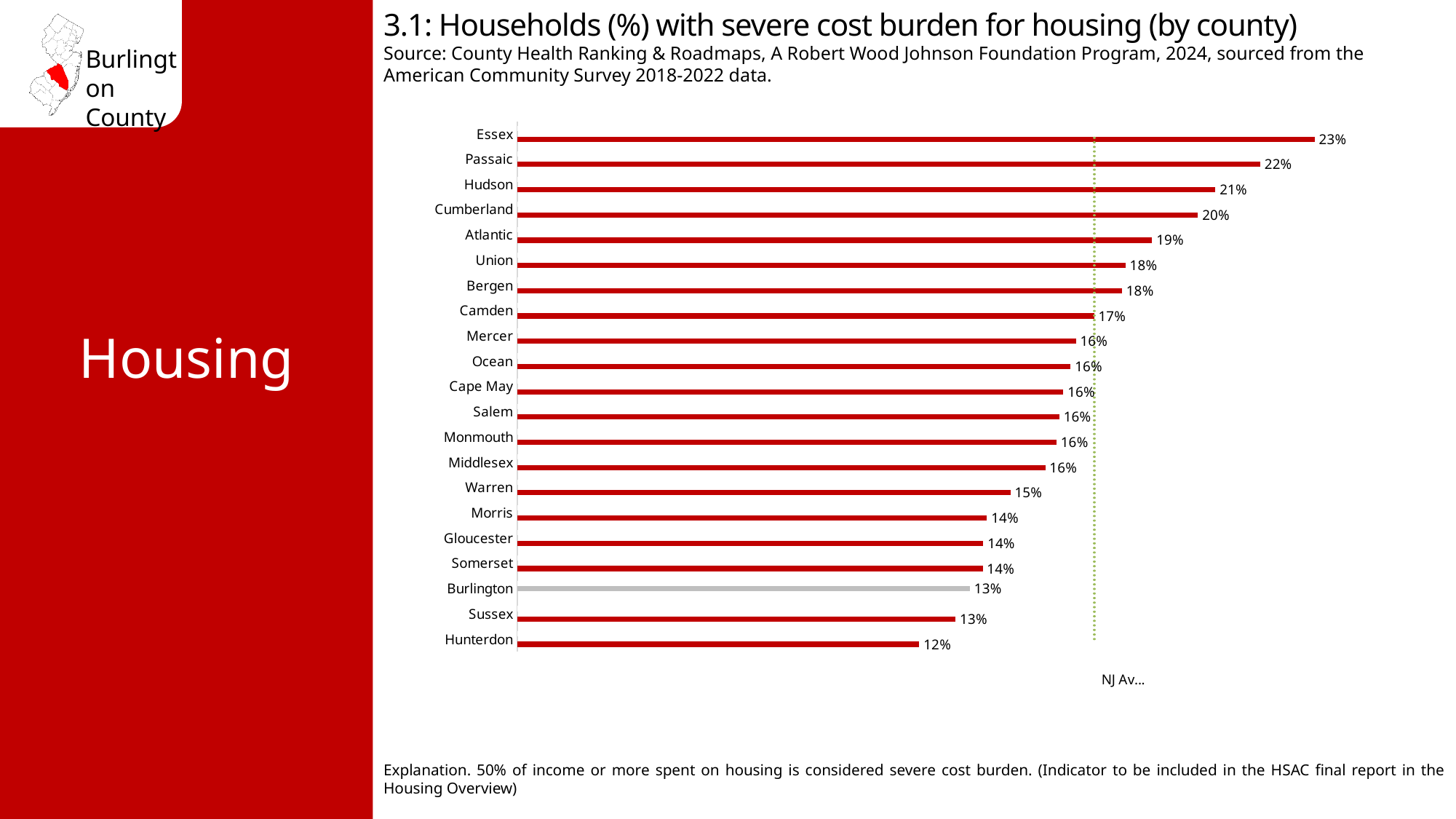
What is the value for Burlington in the chart? 13% Which has a larger value, Passaic or Hudson? Passaic How many counties are shown in the chart? 21 What is the difference between the values for Essex and Hunterdon? 11 percentage points What kind of chart is shown on the slide? Bar chart Which has a larger value, Warren or Morris? Warren What is the value for Atlantic in the chart? 19% Which county has the lowest percentage of households with severe cost burden for housing? Hunterdon Which county has the highest percentage of households with severe cost burden for housing? Essex What is the difference between the values for Cumberland and Burlington? 7 percentage points Which county's bar is drawn in grey rather than red? Burlington What is the value for Essex in the chart? 23%